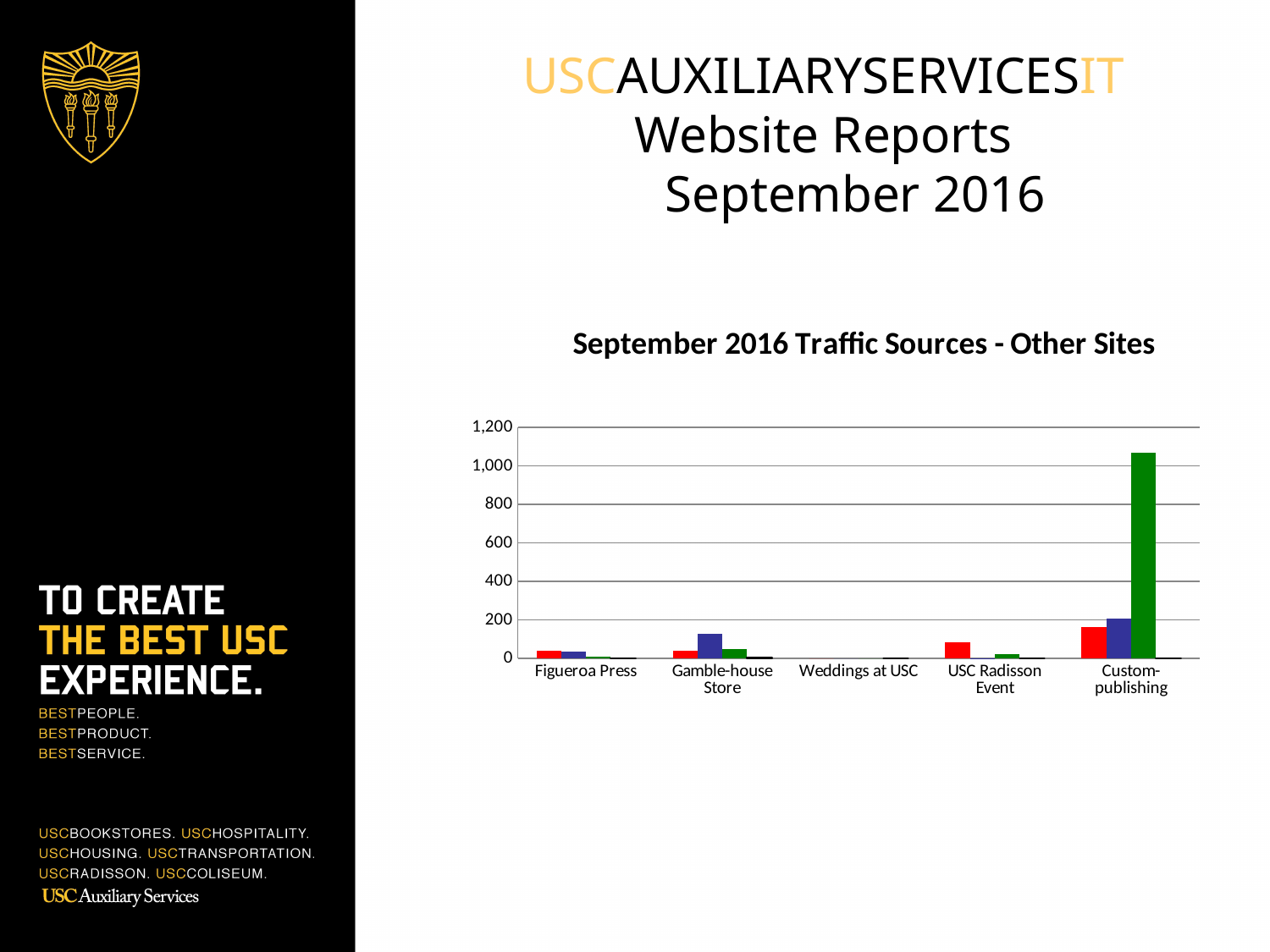
Is the value of the green bar for Custom-publishing greater or less than 1,000? greater What is the title of the chart? September 2016 Traffic Sources - Other Sites Is the value of the blue bar for Gamble-house Store greater or less than 200? less Which is larger: the green bar for Custom-publishing or the blue bar for Gamble-house Store? the green bar for Custom-publishing How many categories are shown on the x axis of the chart? 5 Which is larger: the red bar for Figueroa Press or the red bar for Custom-publishing? the red bar for Custom-publishing What is the highest value shown on the y axis of the chart? 1,200 What kind of chart is shown on the slide? bar chart Which category has the lowest bars overall in the chart? Weddings at USC Which category has the tallest bar in the chart? Custom-publishing Is the value of the red bar for Custom-publishing greater or less than 200? less